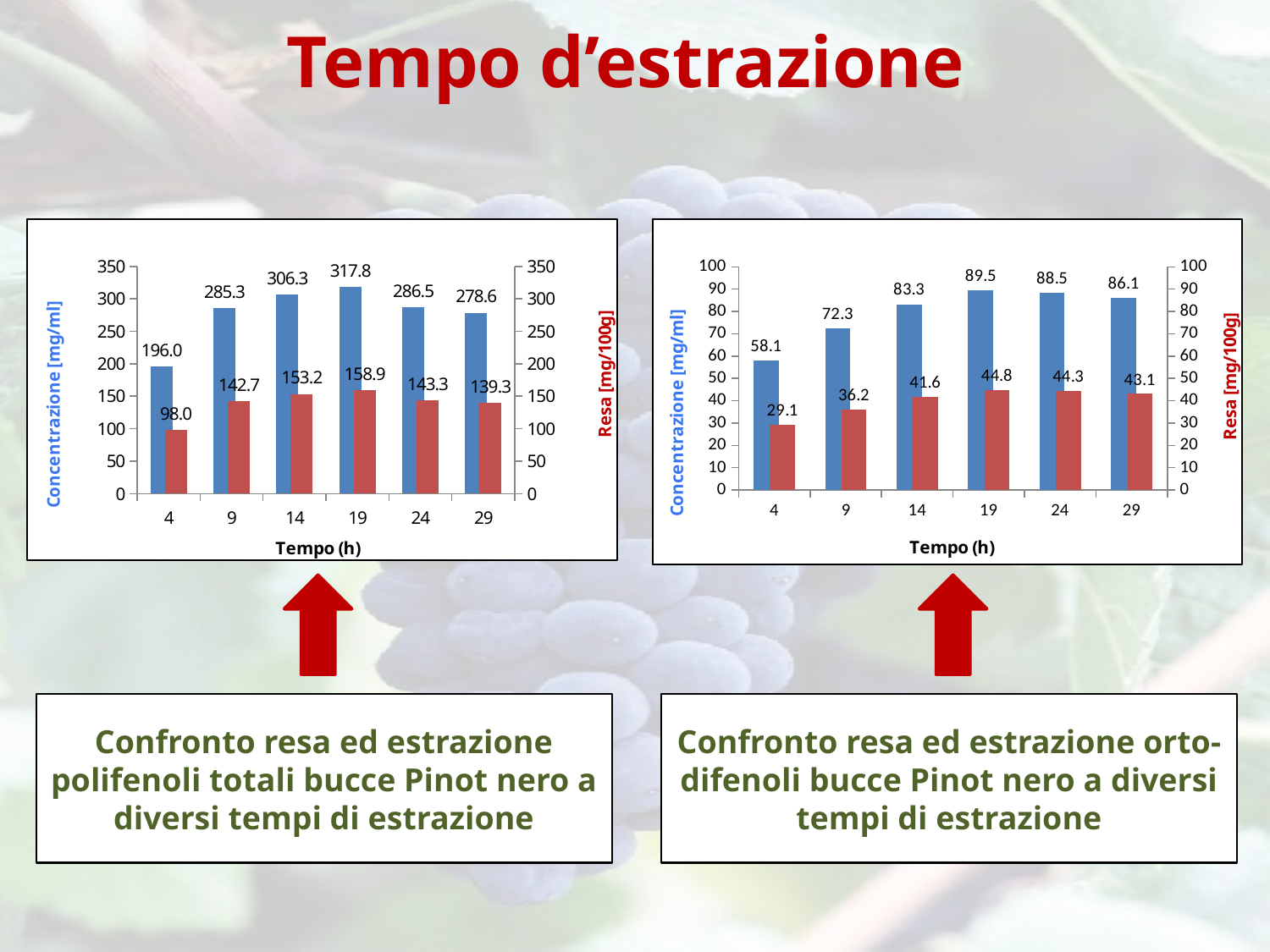
In the left chart, at which time is the concentration (blue bar) highest? 19 In the left chart, what is the concentration (blue bar) at 19 h? 317.8 How many time points are shown on the x axis of the right chart? 6 In the right chart, does the resa (red bar) rise or fall from 4 h to 19 h? rise In the right chart, what is the concentration (blue bar) at 14 h? 83.3 In the right chart, what is the resa (red bar) value at 29 h? 43.1 In the right chart, which is larger: the concentration at 9 h or at 24 h? 24 h What is the x-axis title of the left chart? Tempo (h) In the left chart, what is the difference between the concentration values at 19 h and 4 h? 121.8 What type of chart is the left chart? bar chart In the left chart, what is the resa (red bar) value at 4 h? 98.0 In the right chart, at which time is the resa (red bar) lowest? 4